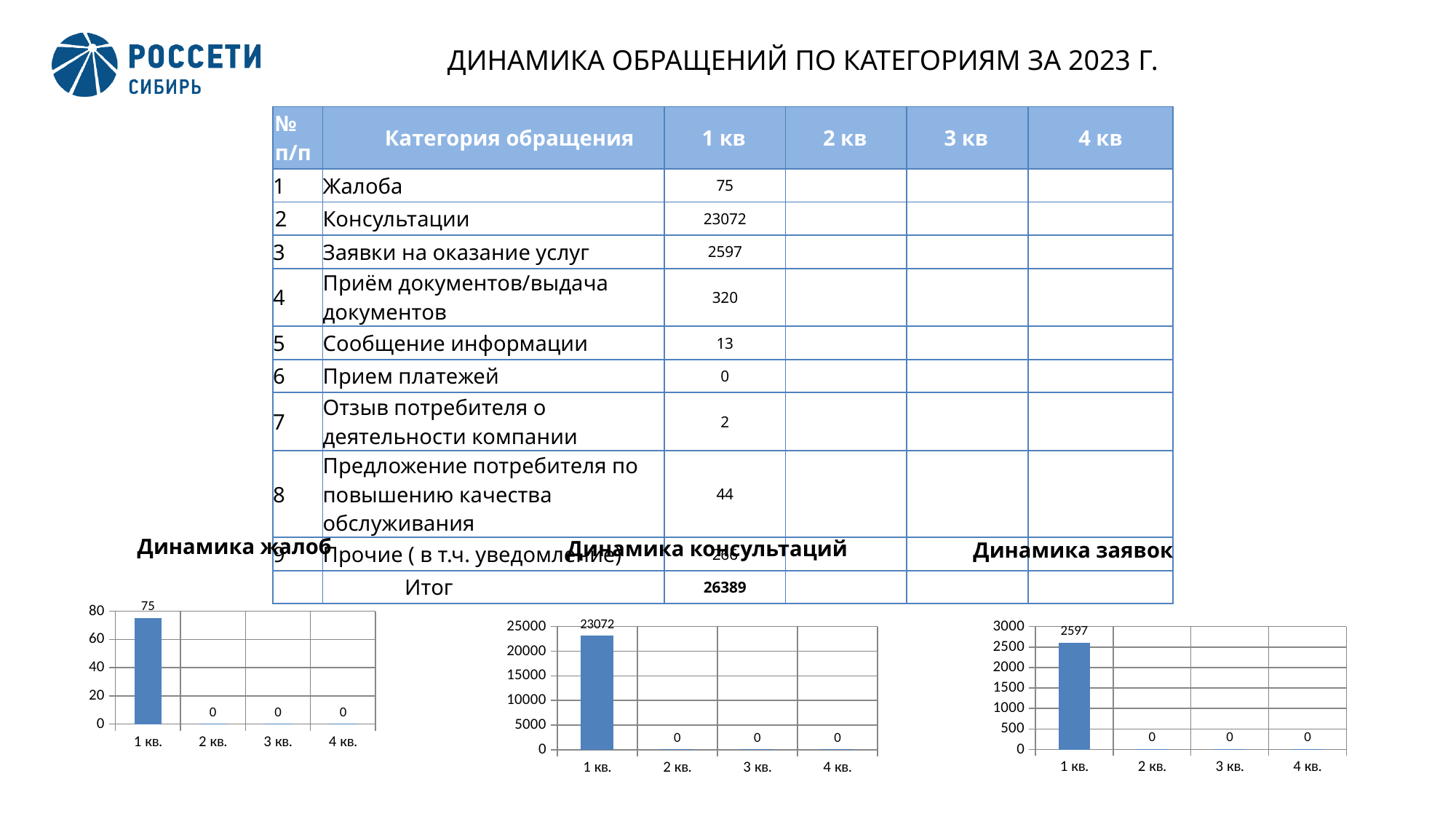
In the 'Динамика заявок' chart, is the value for 1 кв. greater or less than 2000? greater In the 'Динамика консультаций' chart, what is the value for 1 кв.? 23072 In the 'Динамика заявок' chart, what is the value for 1 кв.? 2597 In the 'Динамика консультаций' chart, do the values rise or fall from 1 кв. to 2 кв.? fall In the 'Динамика жалоб' chart, what is the value for 1 кв.? 75 In the 'Динамика консультаций' chart, what is the difference between the values for 1 кв. and 2 кв.? 23072 How many categories are shown on the x axis of the 'Динамика консультаций' chart? 4 In the 'Динамика жалоб' chart, which quarter has the highest value? 1 кв. What kind of chart is 'Динамика жалоб'? bar chart In the 'Динамика заявок' chart, what is the value for 3 кв.? 0 In the 'Динамика заявок' chart, which is larger, the value for 1 кв. or the value for 4 кв.? 1 кв. What is the title of the chart on the right side of the slide? Динамика заявок